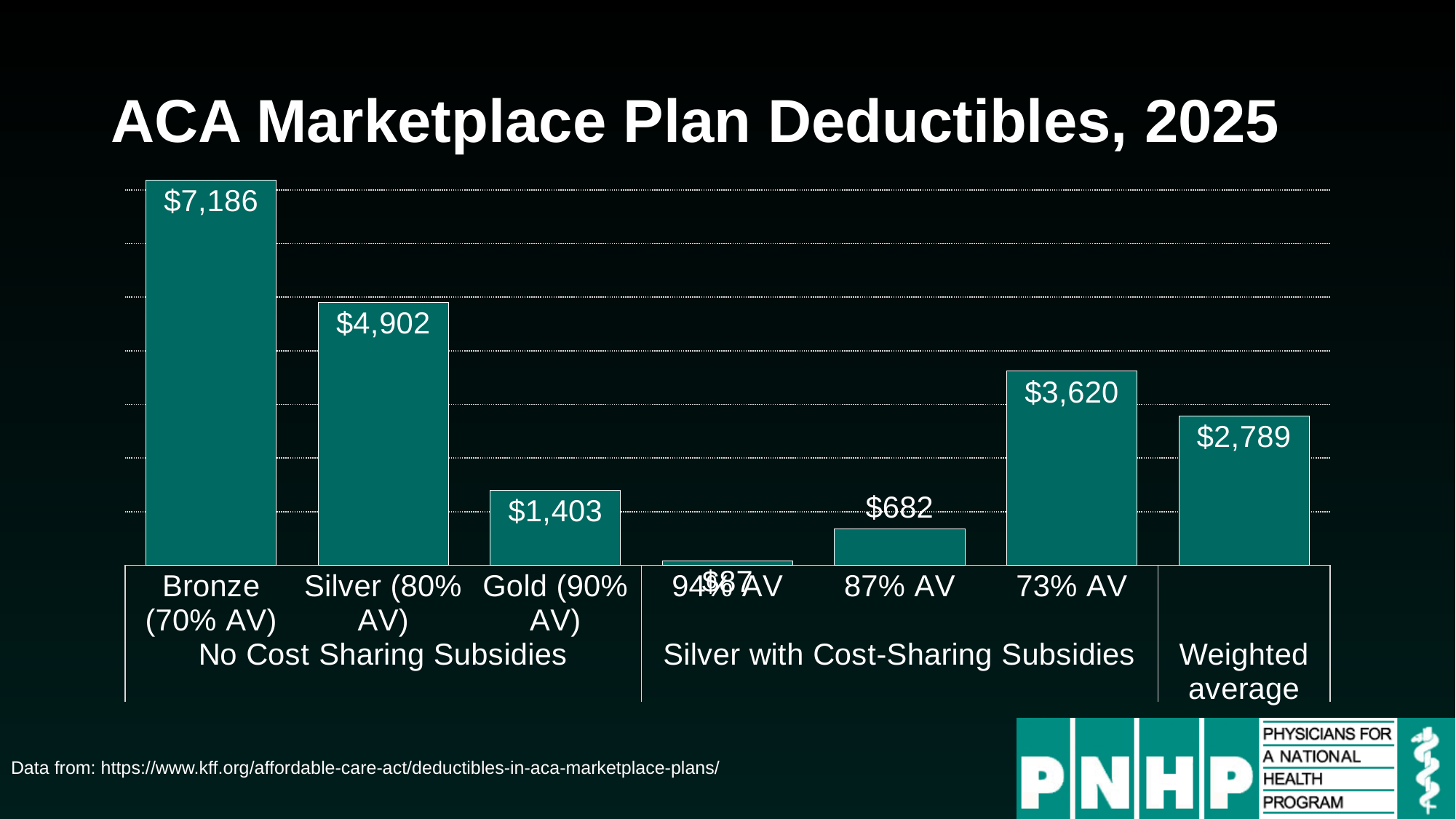
How much higher is the Bronze (70% AV) deductible than the Silver (80% AV) deductible? $2,284 Which plan has the highest deductible? Bronze (70% AV) How many bars are shown on the chart? 7 Which is larger: the deductible for the 73% AV plan or the weighted average? 73% AV What is the weighted average deductible shown on the chart? $2,789 Which plan has the lowest deductible? 94% AV What is the deductible for the 87% AV Silver plan with cost-sharing subsidies? $682 What type of chart is shown on the slide? Bar chart What is the deductible for the 73% AV Silver plan with cost-sharing subsidies? $3,620 What is the deductible for the Gold (90% AV) plan? $1,403 What is the deductible for the Bronze (70% AV) plan? $7,186 What is the deductible for the Silver (80% AV) plan with no cost sharing subsidies? $4,902